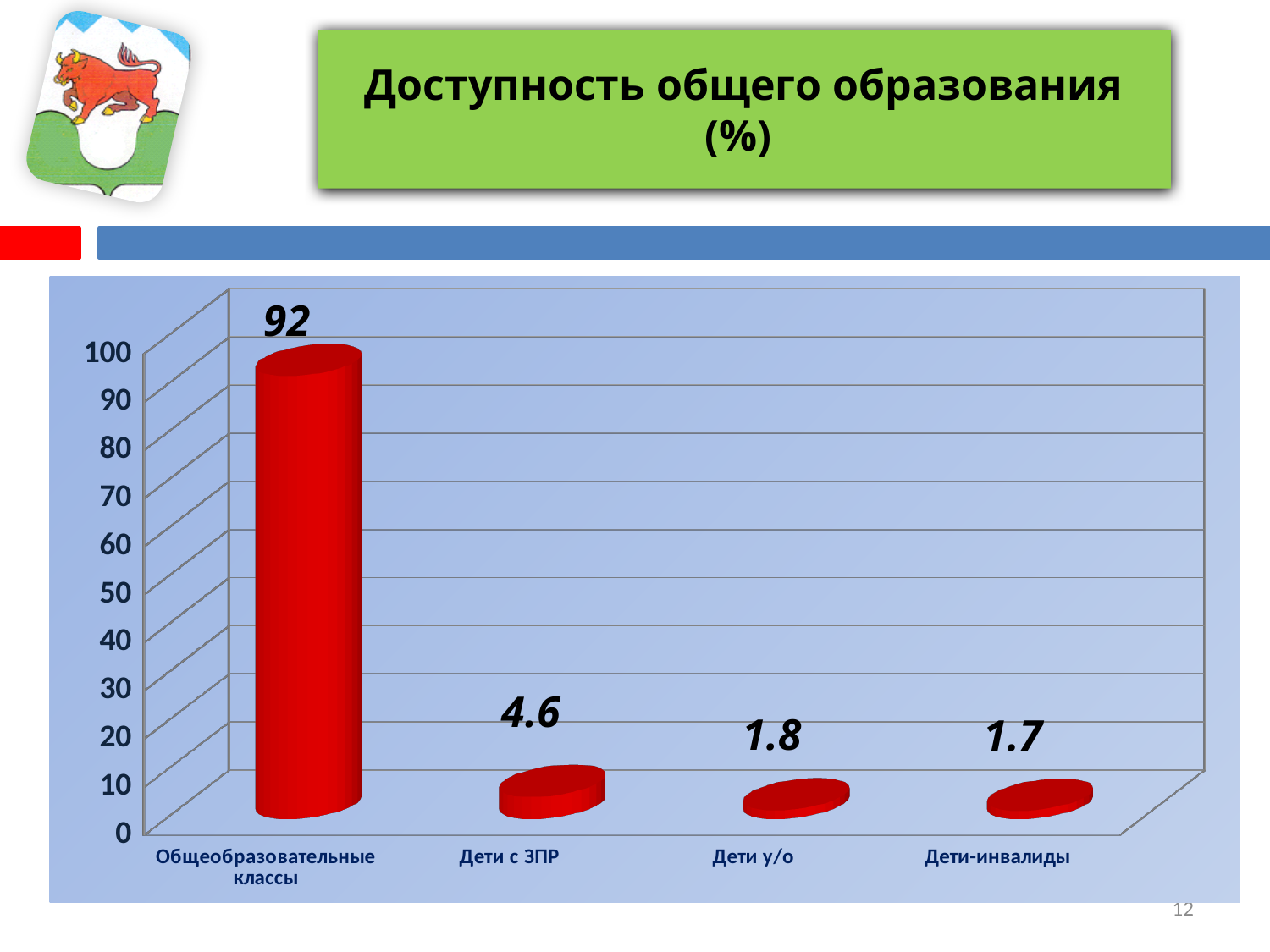
Is the value for Общеобразовательные классы greater or less than 90? greater Which category has the highest value? Общеобразовательные классы What is the value for Дети с ЗПР? 4.6 How many categories are shown on the x axis? 4 Which is larger, the value for Дети с ЗПР or the value for Дети у/о? Дети с ЗПР What is the value for Дети-инвалиды? 1.7 What is the value for Общеобразовательные классы? 92 What is the difference between the values for Дети с ЗПР and Дети у/о? 2.8 What is the value for Дети у/о? 1.8 What is the title of the chart? Доступность общего образования (%) What is the difference between the values for Общеобразовательные классы and Дети с ЗПР? 87.4 What kind of chart is shown on the slide? bar chart